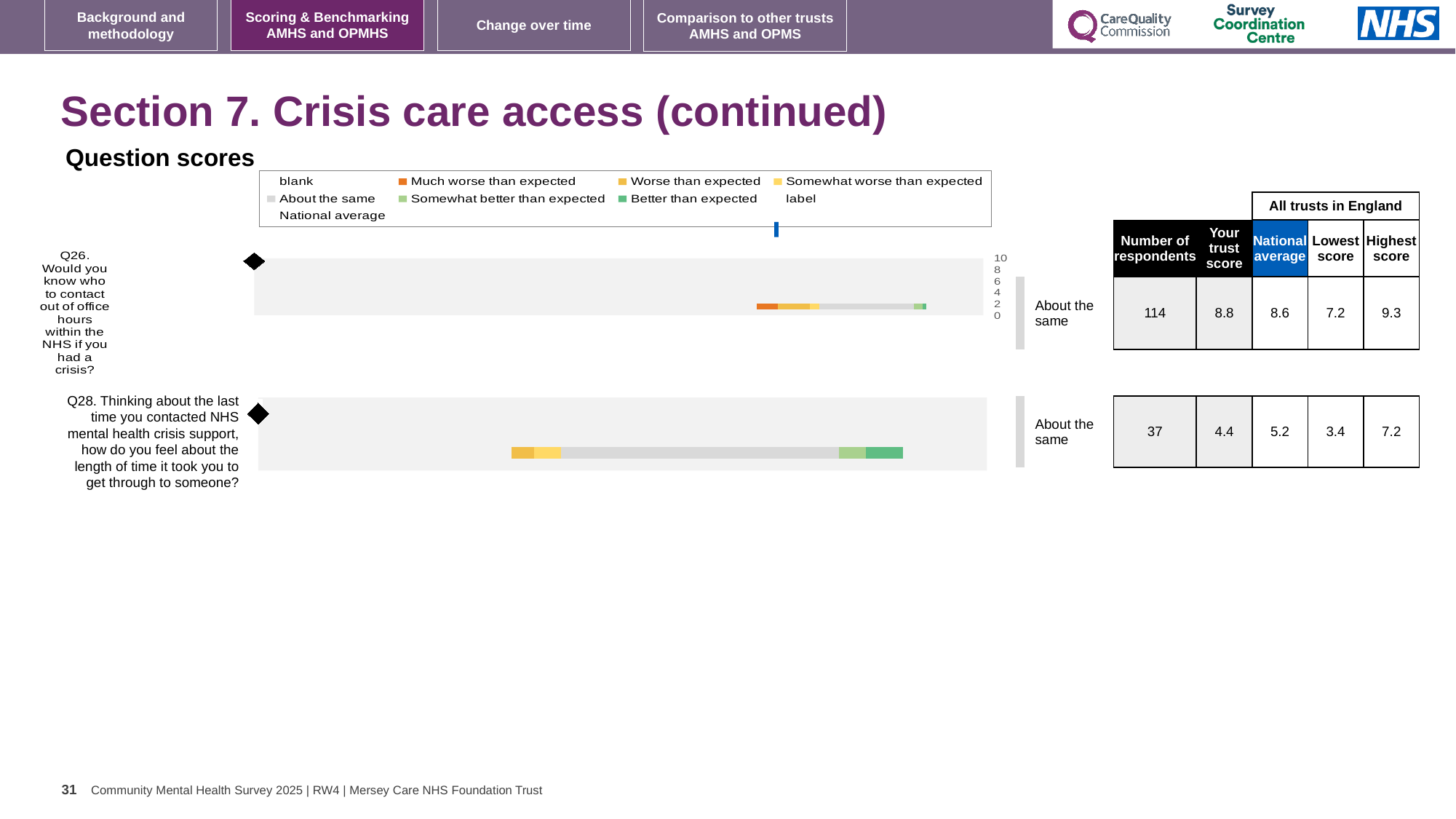
What benchmark category label is shown next to the bar for Q28? About the same What kind of chart is used to show the question scores on this slide? bar chart How many questions are plotted in the question scores chart? 2 What is the difference between the highest and lowest scores for Q26? 2.1 What is the highest score among all trusts in England for Q28? 7.2 What is the difference between the national average and the trust score for Q28? 0.8 What is the trust score for Q26? 8.8 Which question has more respondents, Q26 or Q28? Q26 What is the number of respondents for Q26 (Would you know who to contact out of office hours within the NHS if you had a crisis?)? 114 For Q26, which is larger: the trust score or the national average? the trust score What is the trust score for Q28 (length of time it took to get through to someone)? 4.4 What is the national average for Q26? 8.6